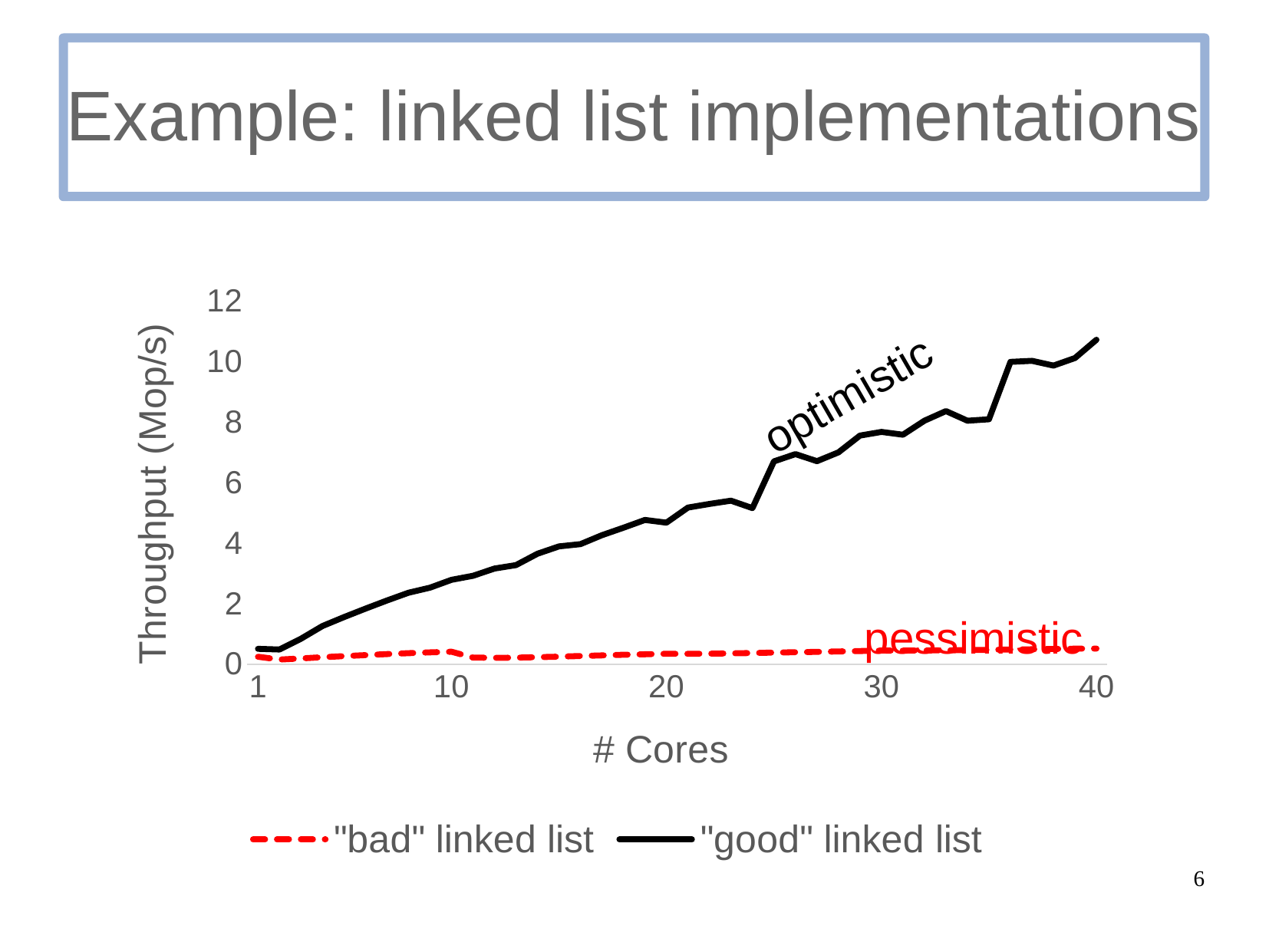
What is the label of the y axis? Throughput (Mop/s) Which series has the lowest throughput across the chart? "bad" linked list Does the throughput of the "good" linked list rise or fall as the number of cores increases? rise Is the throughput of the "bad" linked list at 40 cores greater or less than 2? less How many series does the legend list? 2 Which series is drawn as a red dashed line? "bad" linked list Is the throughput of the "good" linked list at 20 cores greater or less than 6? less At 30 cores, which series has the higher throughput, the "bad" linked list or the "good" linked list? "good" linked list What kind of chart is shown on the slide? line chart Which series reaches the highest throughput on the chart? "good" linked list Is the throughput of the "good" linked list at 40 cores greater or less than 10? greater